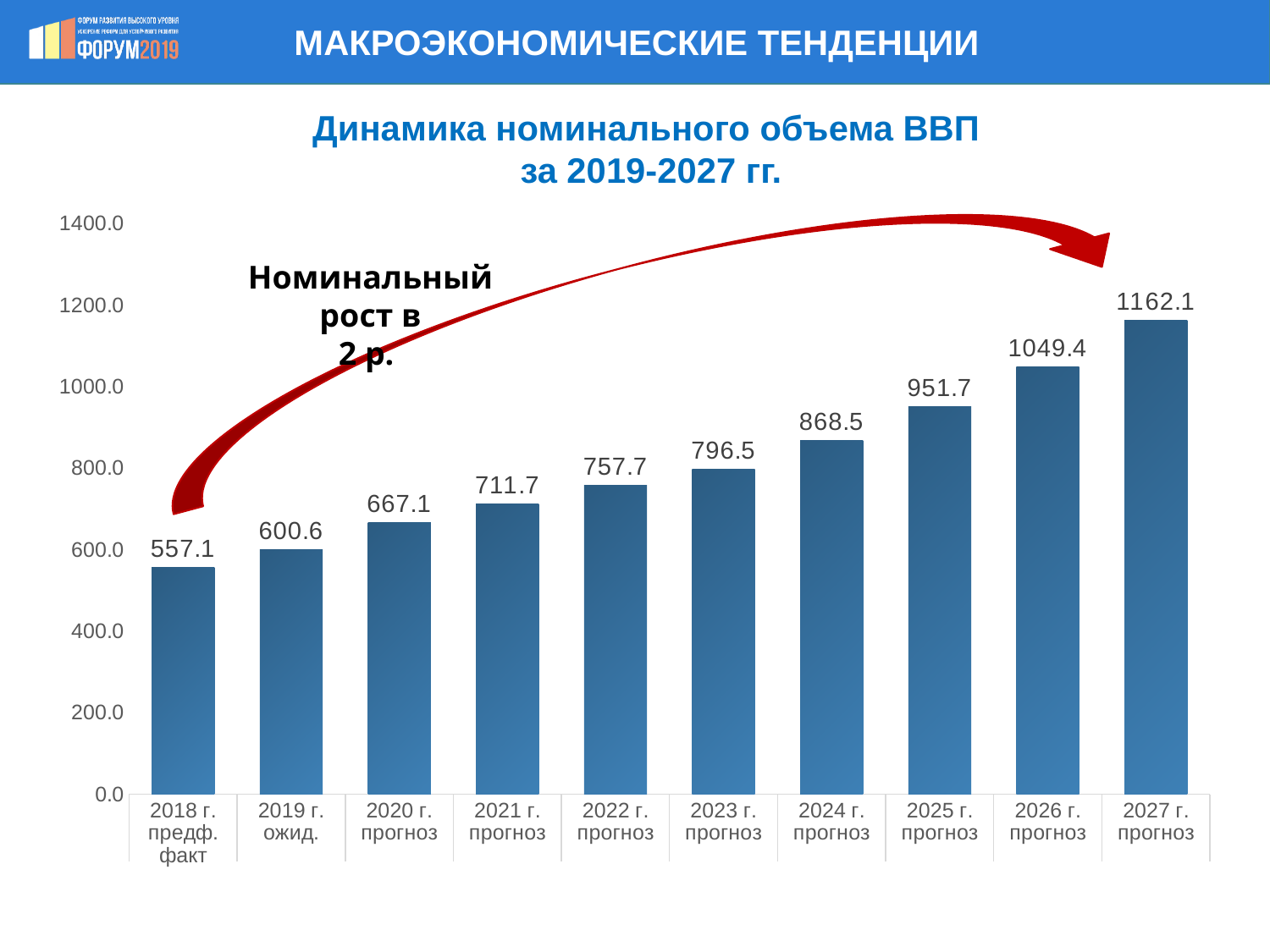
Which year has the highest value? 2027 г. прогноз What is the value for 2018 г. предф. факт? 557.1 How many years are shown on the x axis? 10 Is the value for 2020 г. прогноз greater or less than 600.0? greater What is the value for 2025 г. прогноз? 951.7 What is the difference between the values for 2024 г. прогноз and 2023 г. прогноз? 72.0 What is the difference between the values for 2027 г. прогноз and 2018 г. предф. факт? 605.0 What kind of chart is this? bar chart What is the value for 2021 г. прогноз? 711.7 Do the values rise or fall from 2018 to 2027? rise Which is larger, the value for 2022 г. прогноз or the value for 2026 г. прогноз? 2026 г. прогноз Which year has the lowest value? 2018 г. предф. факт